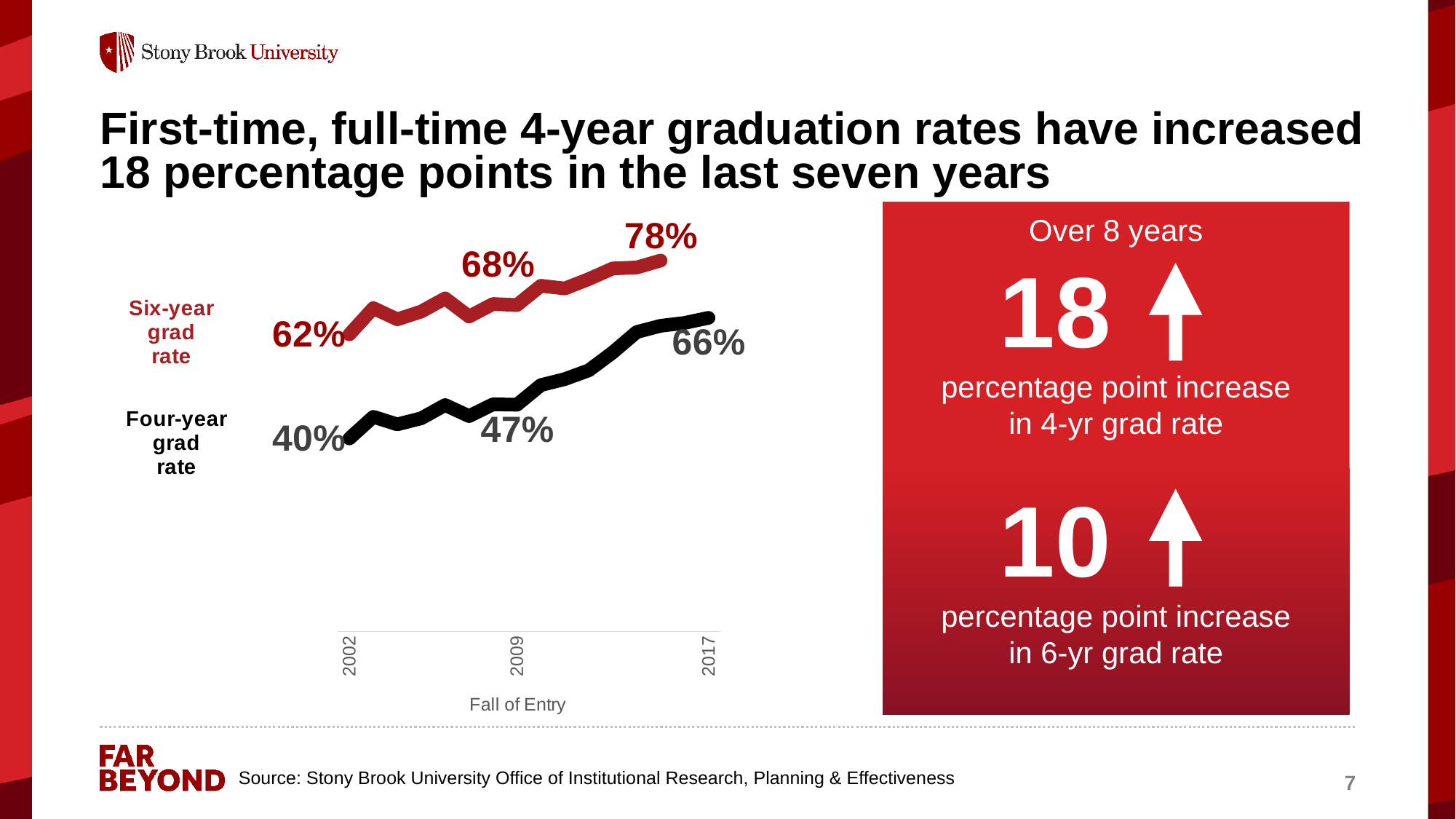
What was the six-year grad rate for the 2002 fall of entry? 62% By how many percentage points did the four-year grad rate rise from 40% to its latest labelled value of 66%? 26 Which line is higher throughout the chart, the six-year grad rate or the four-year grad rate? Six-year grad rate What was the six-year grad rate for the 2009 fall of entry? 68% What kind of chart is shown on the slide? line chart What is the latest labelled four-year grad rate on the chart? 66% What is the label of the x axis of the chart? Fall of Entry What was the four-year grad rate for the 2009 fall of entry? 47% What was the four-year grad rate for the 2002 fall of entry? 40% What is the difference between the six-year and four-year grad rates for the 2002 fall of entry? 22 percentage points What is the latest labelled six-year grad rate on the chart? 78% Do the graduation rates rise or fall over the fall-of-entry years shown? rise